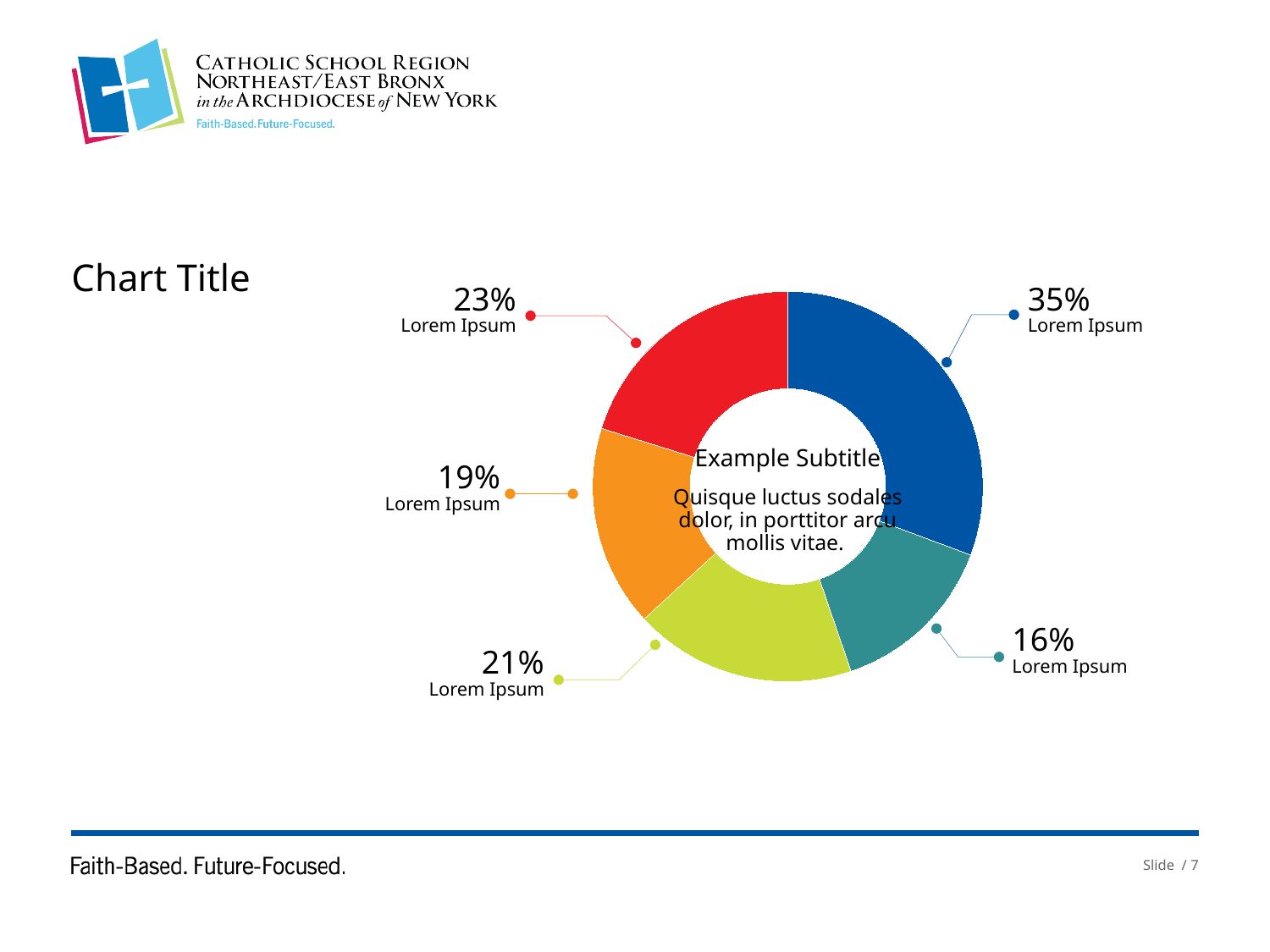
What percentage is shown for the orange slice? 19% Which is larger, the red slice or the yellow-green slice? The red slice (23%) What is the difference between the blue slice's percentage and the teal slice's percentage? 19% How many slices does the chart have? 5 What percentage is shown for the blue slice? 35% What is the title of the chart? Chart Title Which slice has the smallest share? The teal slice (16%) What percentage is shown for the red slice? 23% What kind of chart is shown on the slide? Pie chart (donut) Which slice has the largest share? The blue slice (35%) What percentage is shown for the yellow-green slice? 21% What percentage is shown for the teal slice? 16%